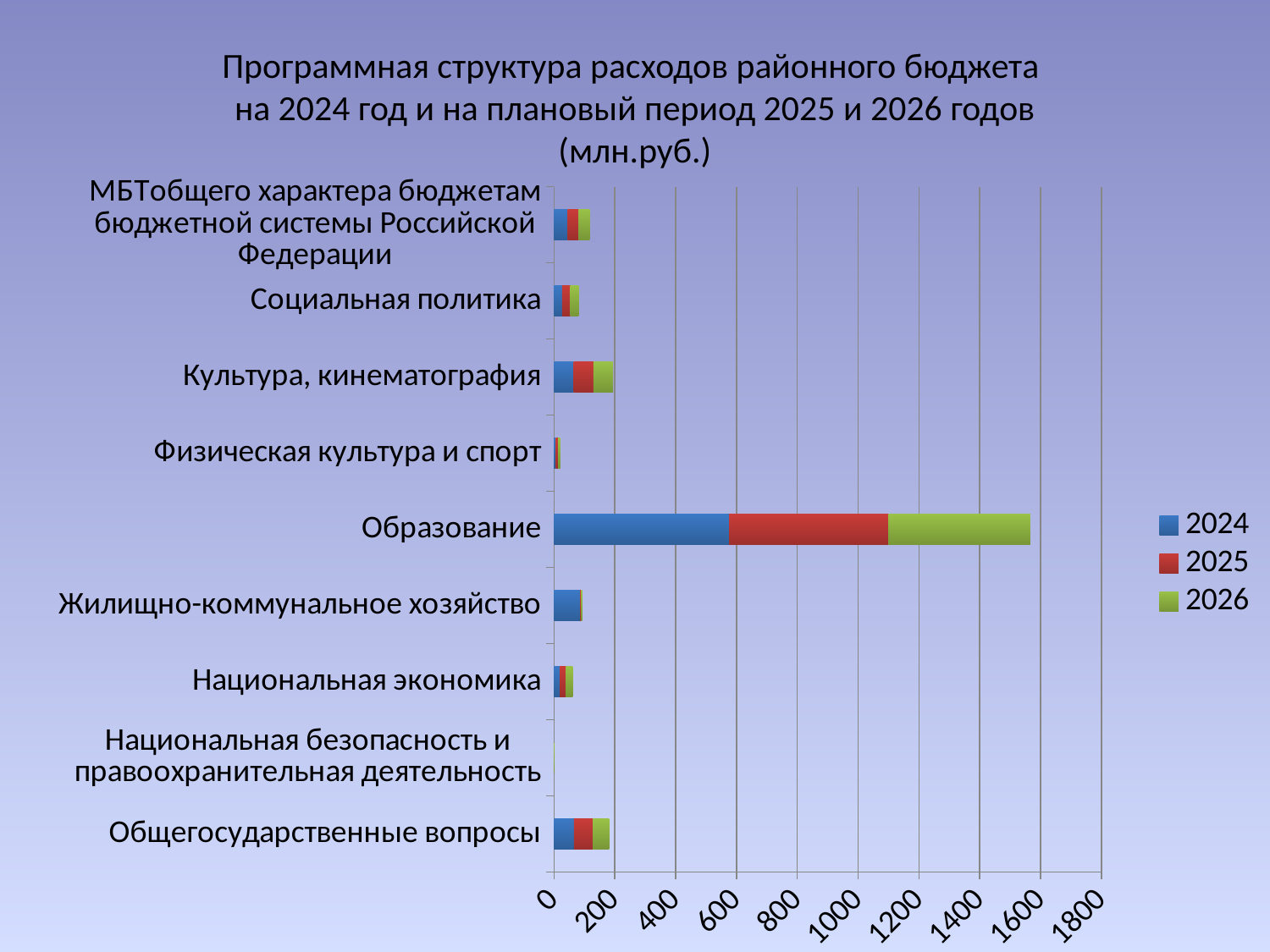
Is the total value for Культура, кинематография greater or less than 400? less Which category has the highest total expenditure? Образование How many categories are shown on the vertical axis? 9 Is the total value for Образование greater or less than 1400? greater What unit of measurement is given in the chart title? млн.руб. Is the 2024 value for Образование greater or less than 400? greater What kind of chart is shown on the slide? stacked bar chart Which has a larger total: Образование or Общегосударственные вопросы? Образование What years are listed in the legend? 2024, 2025, 2026 How many series does the legend list? 3 Which category has the lowest total expenditure? Национальная безопасность и правоохранительная деятельность